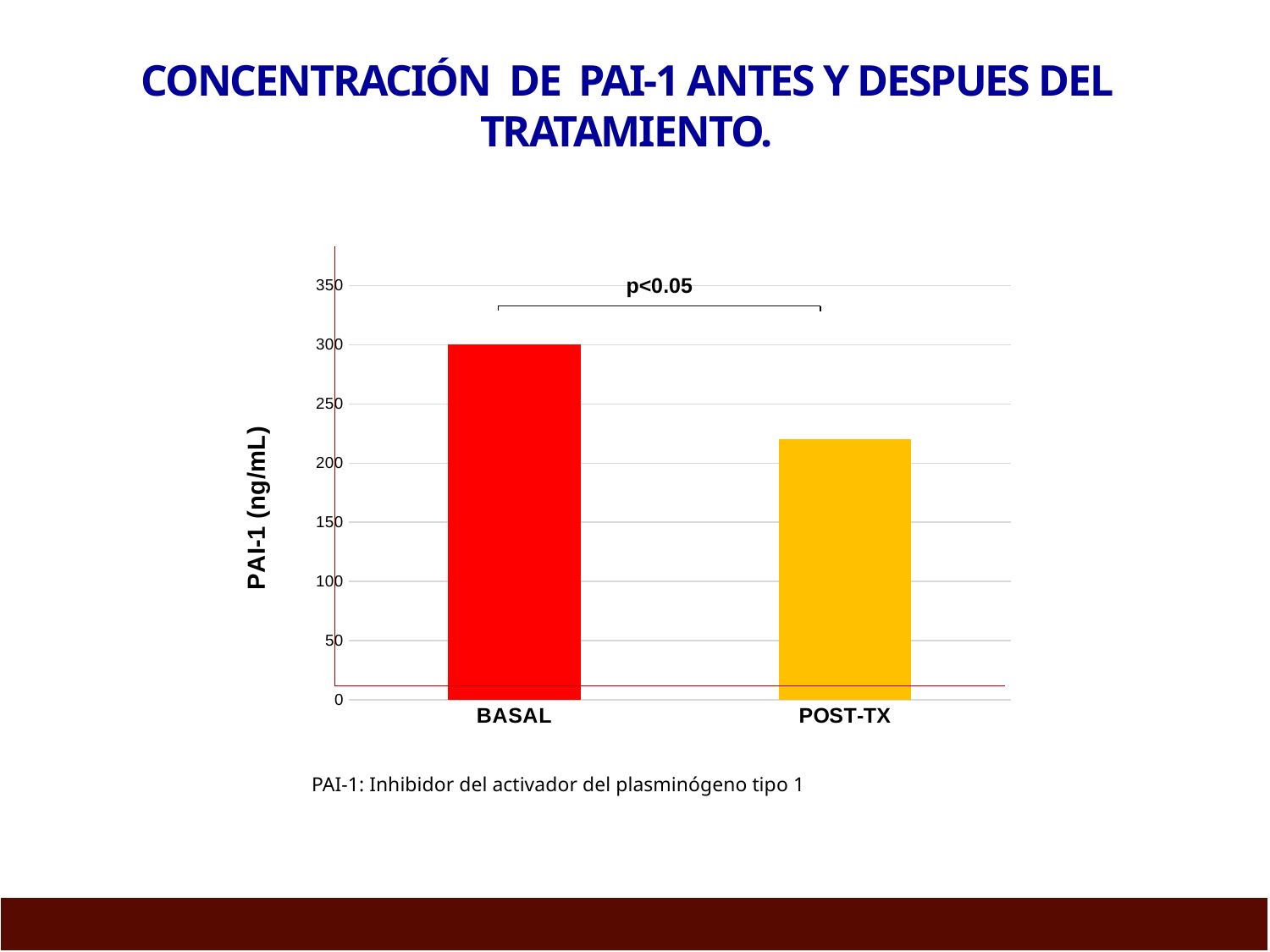
Do the values rise or fall from BASAL to POST-TX? fall Which category has the lowest PAI-1 concentration? POST-TX What is the PAI-1 value for BASAL? 300 Is the value for POST-TX greater or less than 250? less What p-value annotation is shown above the bars? p<0.05 Which is larger, the value for BASAL or the value for POST-TX? BASAL What is the label of the y axis? PAI-1 (ng/mL) Which category has the highest PAI-1 concentration? BASAL What kind of chart is shown on the slide? bar chart How many categories are plotted on the x axis? 2 Is the value for POST-TX greater or less than 200? greater